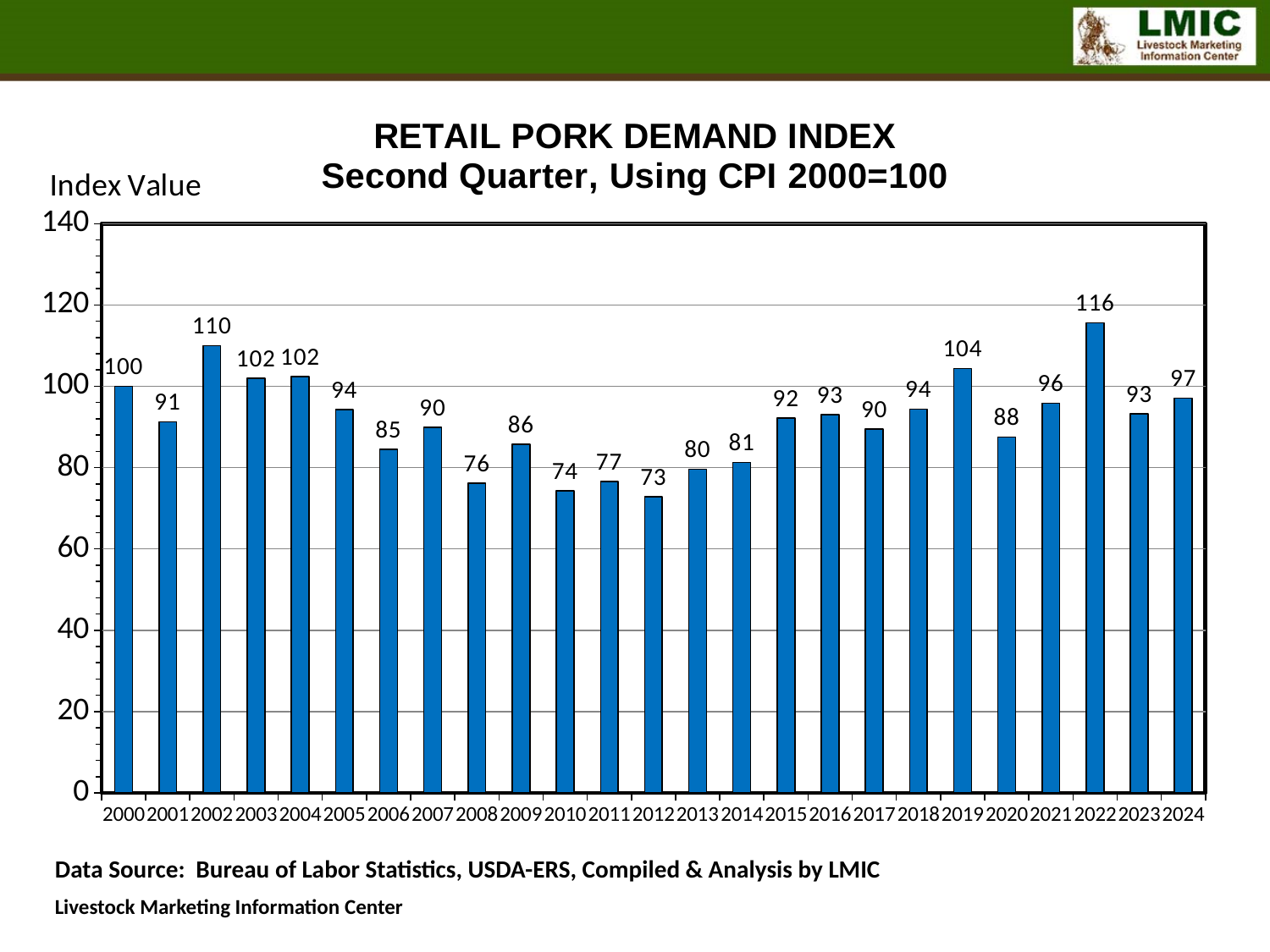
What is the index value for 2019? 104 Which year has a higher index value, 2002 or 2019? 2002 What is the label on the y axis of the chart? Index Value Do the index values rise or fall from 2019 to 2020? fall Which year has the highest index value? 2022 What kind of chart is shown on the slide? bar chart What is the difference between the index values for 2022 and 2012? 43 What is the Retail Pork Demand Index value for 2022? 116 What is the index value for 2012? 73 Is the index value for 2008 greater or less than 80? less How many years are shown on the x axis? 25 Which year has the lowest index value? 2012